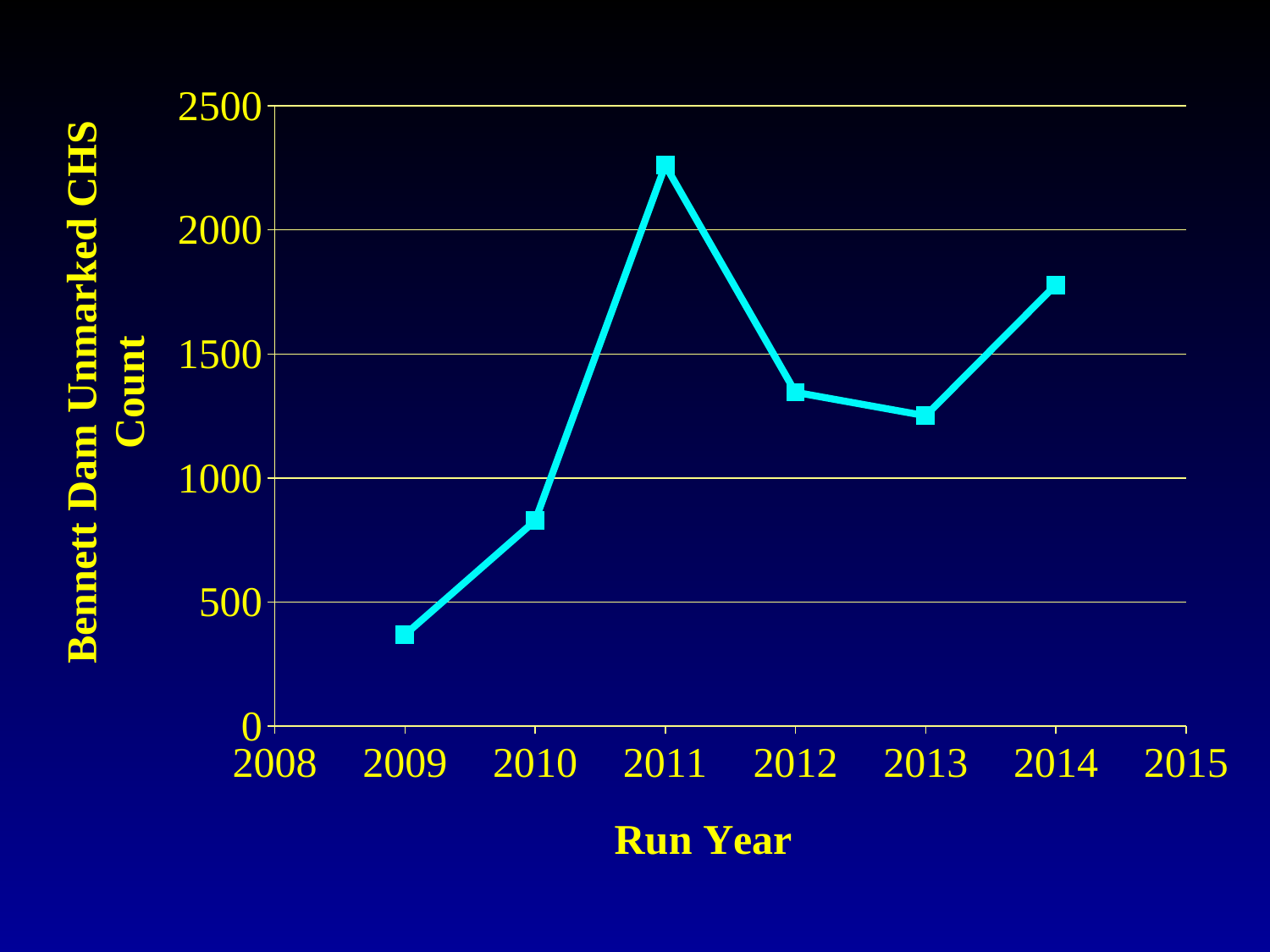
Is the value for 2009 greater or less than 500? less Is the value for 2011 greater or less than 2000? greater Which run year has the larger count, 2010 or 2014? 2014 Is the value for 2010 greater or less than 1000? less What kind of chart is shown on the slide? line chart What is the label on the x axis? Run Year How many data points are plotted on the line? 6 Which run year has the highest Bennett Dam Unmarked CHS Count? 2011 Which run year has the lowest Bennett Dam Unmarked CHS Count? 2009 Does the count rise or fall from 2009 to 2011? rise